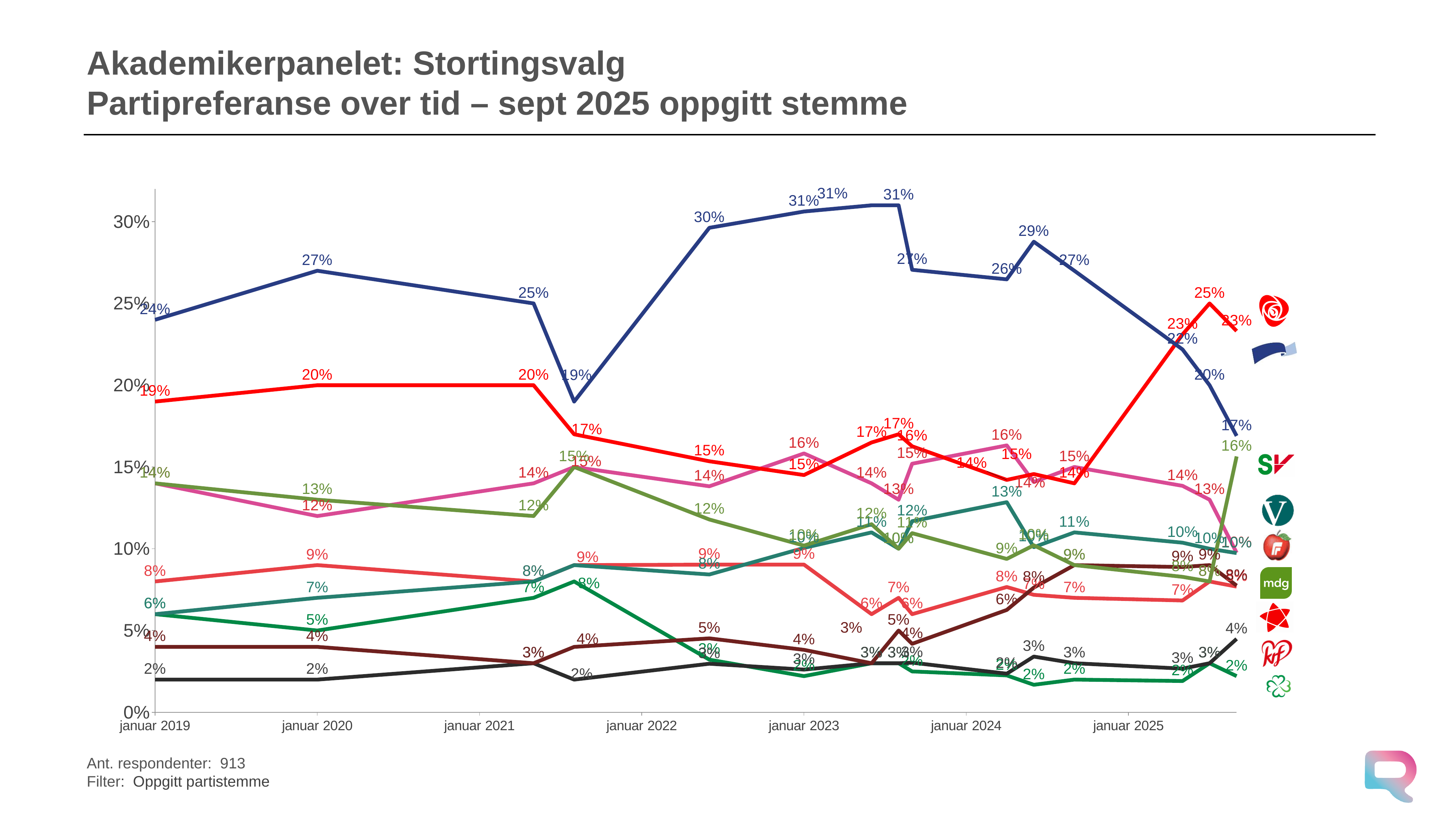
What value does the red line show at januar 2021? 20% What is the last (rightmost) value labelled on the dark blue line? 17% What kind of chart is shown on the slide? line chart What is the last (rightmost) value labelled on the red line? 23% How many respondents (Ant. respondenter) does the slide report? 913 What is the highest value labelled anywhere on the chart? 31% What value does the dark blue line show at januar 2019? 24% Does the dark blue line rise or fall from its 29% point in 2024 to the end of the chart? fall At januar 2019, which is higher: the dark blue line or the red line? the dark blue line What value does the black line show at januar 2019? 2% What value does the dark blue line show at januar 2020? 27% At januar 2020, what is the difference between the dark blue line (27%) and the red line (20%)? 7 percentage points